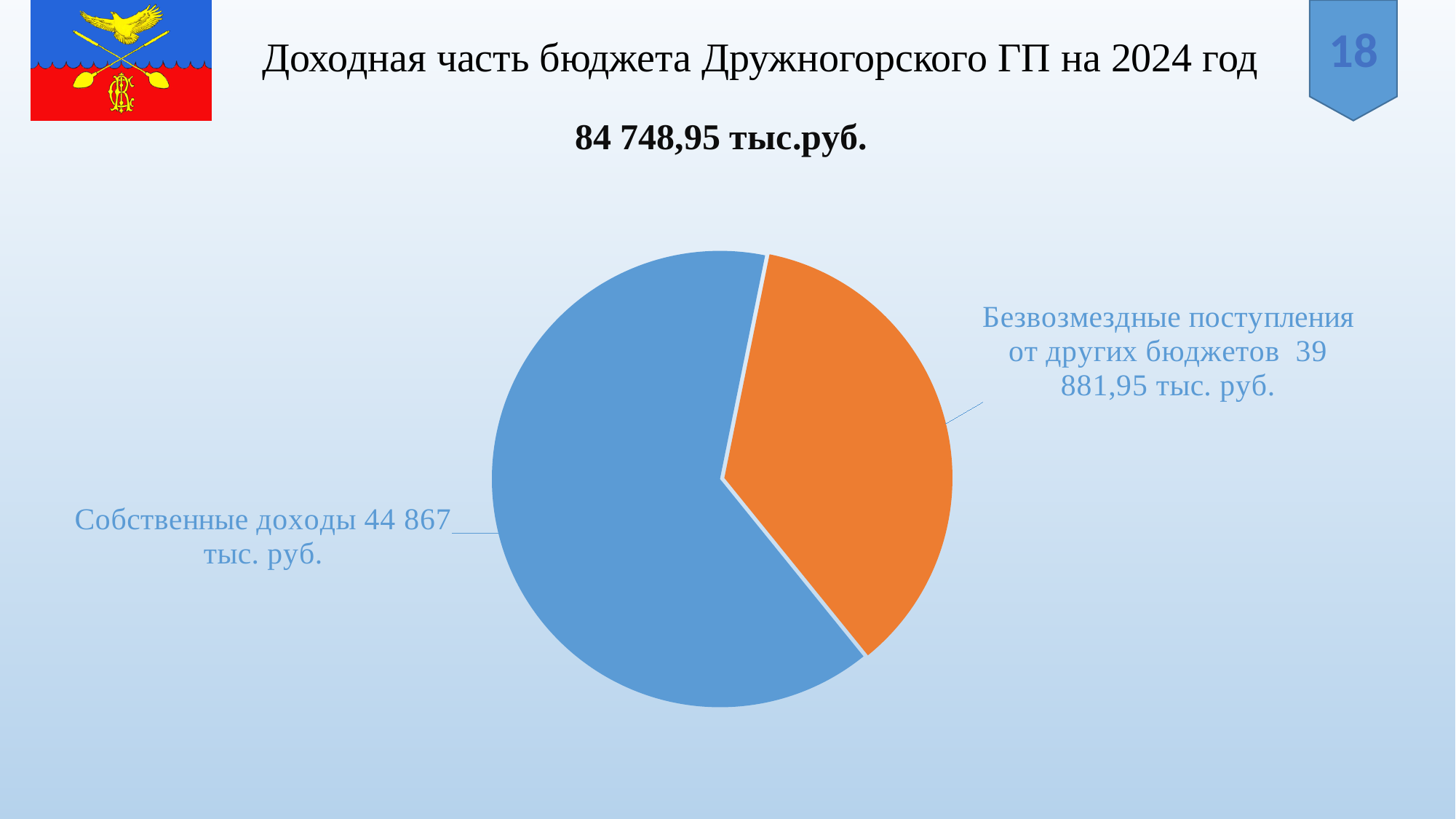
What is the value of the Собственные доходы slice? 44 867 тыс. руб. Which slice of the pie chart is the largest? Собственные доходы Which slice of the pie chart is the smallest? Безвозмездные поступления от других бюджетов What is the value of the Безвозмездные поступления от других бюджетов slice? 39 881,95 тыс. руб. What is the total revenue shown for the budget? 84 748,95 тыс.руб. How many slices does the pie chart have? 2 What is the title of the slide? Доходная часть бюджета Дружногорского ГП на 2024 год What is the difference between Собственные доходы and Безвозмездные поступления от других бюджетов? 4 985,05 тыс. руб. What kind of chart is shown on the slide? Pie chart What colour is the Собственные доходы slice? Blue Which is larger: Собственные доходы or Безвозмездные поступления от других бюджетов? Собственные доходы